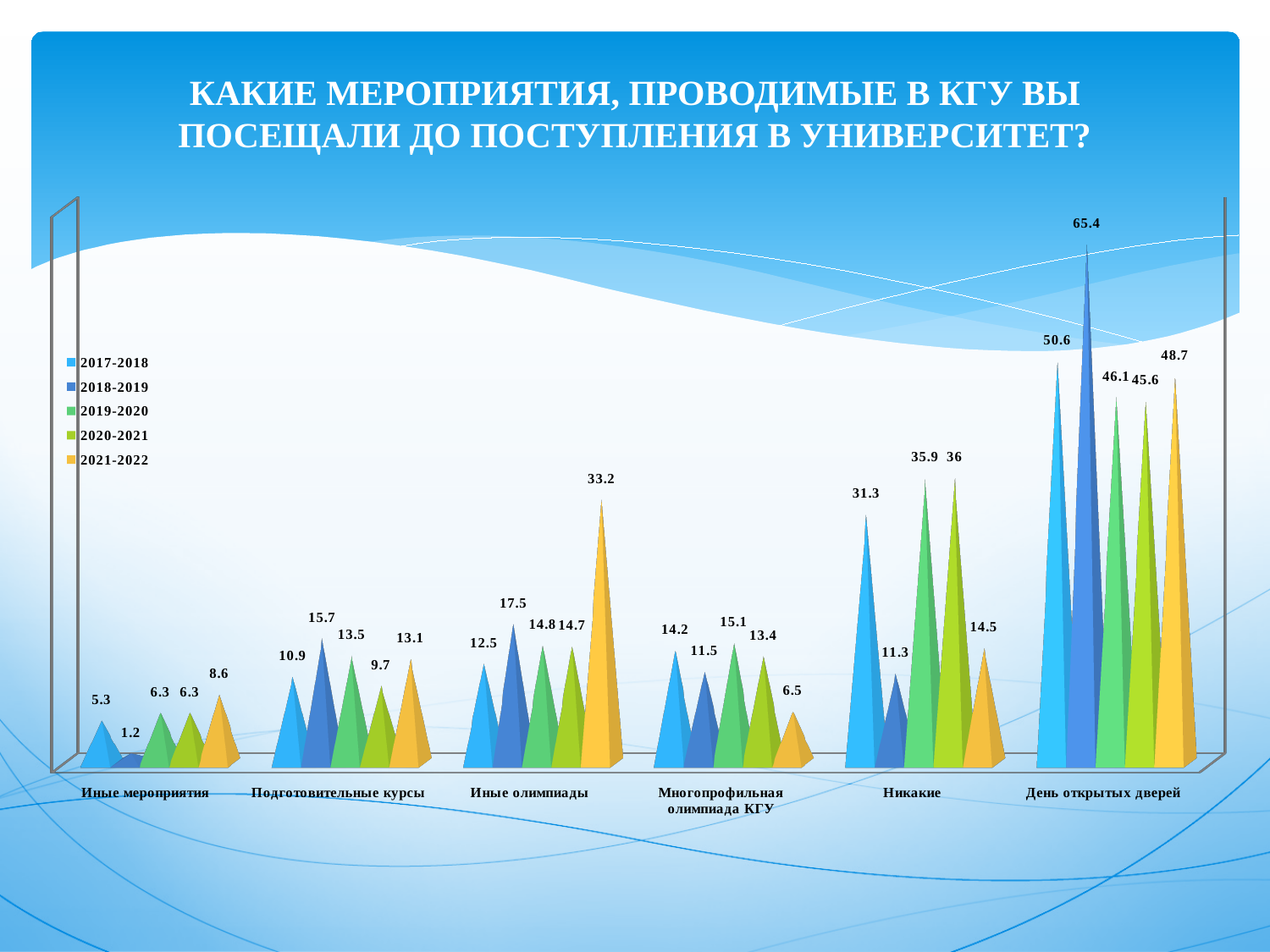
What is the difference between the 2018-2019 and 2017-2018 values in the category День открытых дверей? 14.8 What is the value for 2021-2022 in the category Иные олимпиады? 33.2 Which series is shown in yellow according to the legend? 2021-2022 What is the value for 2018-2019 in the category День открытых дверей? 65.4 What kind of chart is shown on the slide? Bar chart Which category has the highest value for the 2019-2020 series? День открытых дверей How many series does the legend list? 5 What is the value for 2017-2018 in the category Никакие? 31.3 Which category has the lowest value for the 2018-2019 series? Иные мероприятия Which is larger in the category Никакие: the 2019-2020 value or the 2020-2021 value? 2020-2021 How many categories are shown on the x axis? 6 What is the value for 2020-2021 in the category Подготовительные курсы? 9.7